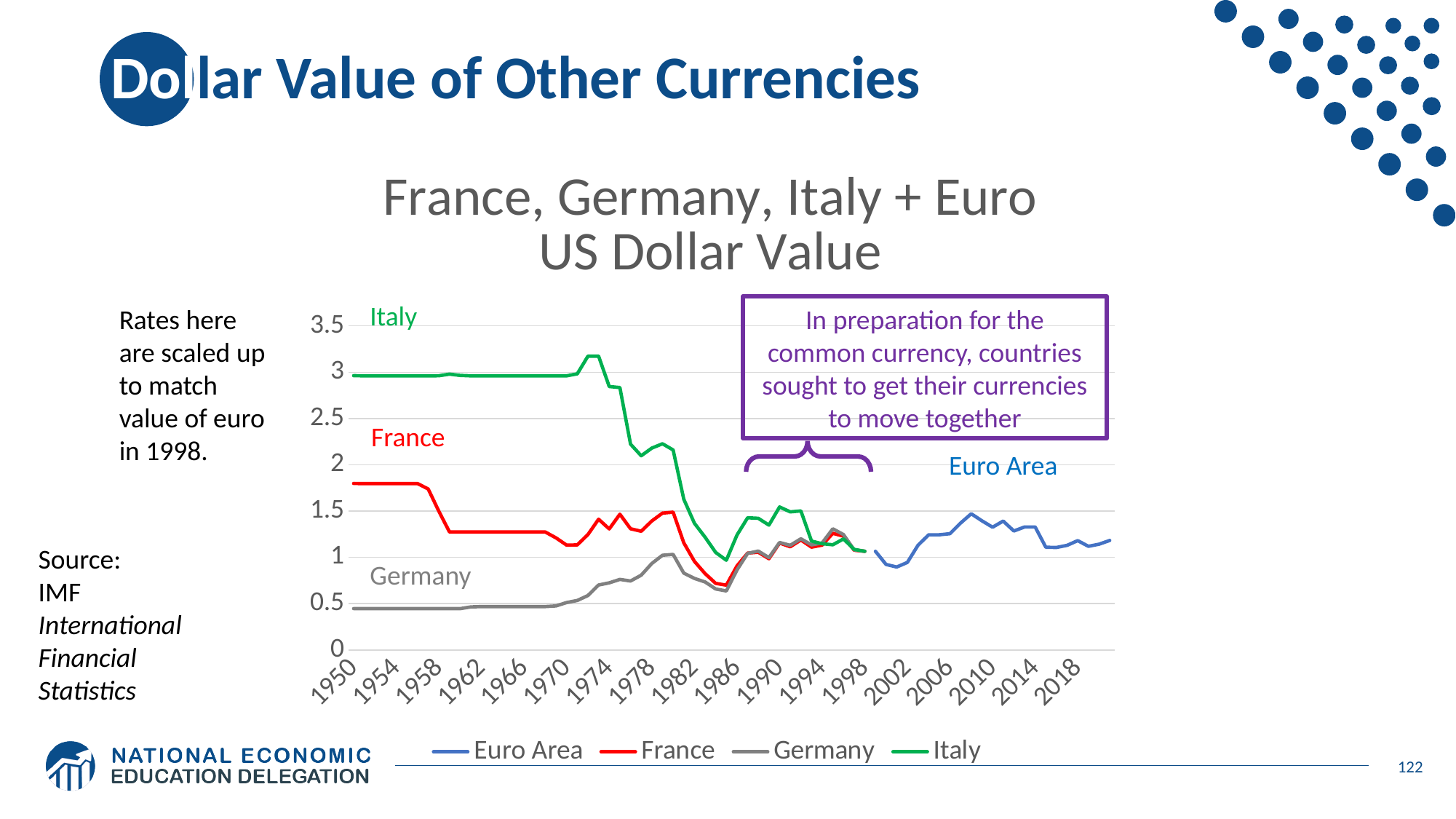
How many series does the chart legend list? 4 What kind of chart is shown on the slide? Line chart What is the title of the chart? France, Germany, Italy + Euro US Dollar Value Which currency had the highest US dollar value in 1950? Italy Is the value for Italy in 1950 greater or less than 2.5? greater In 1970, which was higher: the value for France or the value for Germany? France Which series is plotted in green? Italy Is the value for the Euro Area in 2002 greater or less than 1? less Is the value for France in 1950 greater or less than 1.5? greater Which currency had the lowest US dollar value in 1950? Germany Does the value for Italy rise or fall between 1950 and 1986? Falls